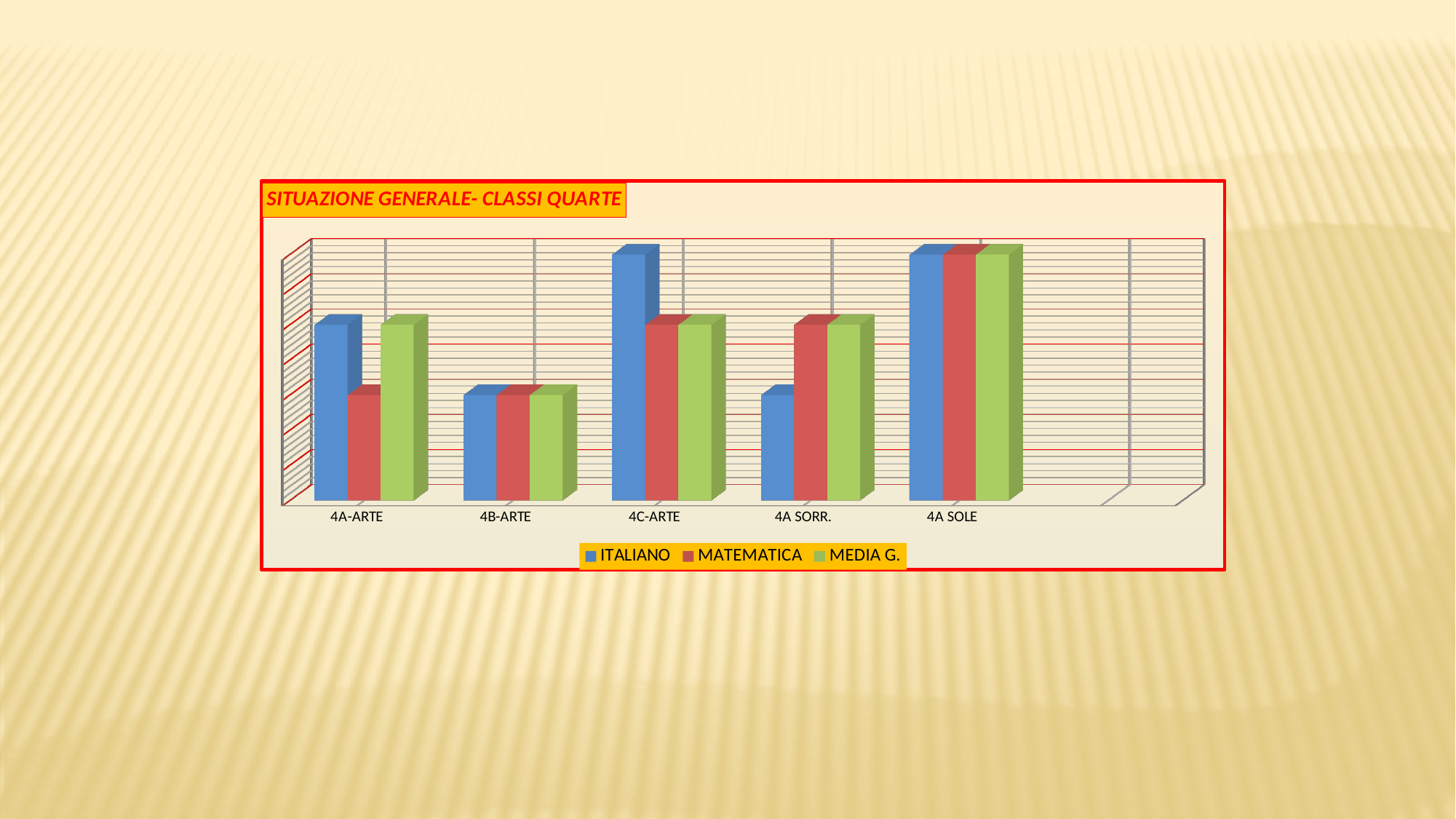
For 4C-ARTE, which is larger: ITALIANO or MEDIA G.? ITALIANO How many classes (categories) are shown on the x axis? 5 For 4A-ARTE, which series has the lowest bar? MATEMATICA Which class has the highest MEDIA G. bar? 4A SOLE For 4A SORR., which is larger: ITALIANO or MATEMATICA? MATEMATICA What is the title of the chart? SITUAZIONE GENERALE- CLASSI QUARTE Which colour represents the MATEMATICA series? red For 4A-ARTE, which is larger: ITALIANO or MATEMATICA? ITALIANO Which class has the lowest MEDIA G. bar? 4B-ARTE Which class has the highest MATEMATICA bar? 4A SOLE How many series does the legend list? 3 What kind of chart is shown on the slide? bar chart